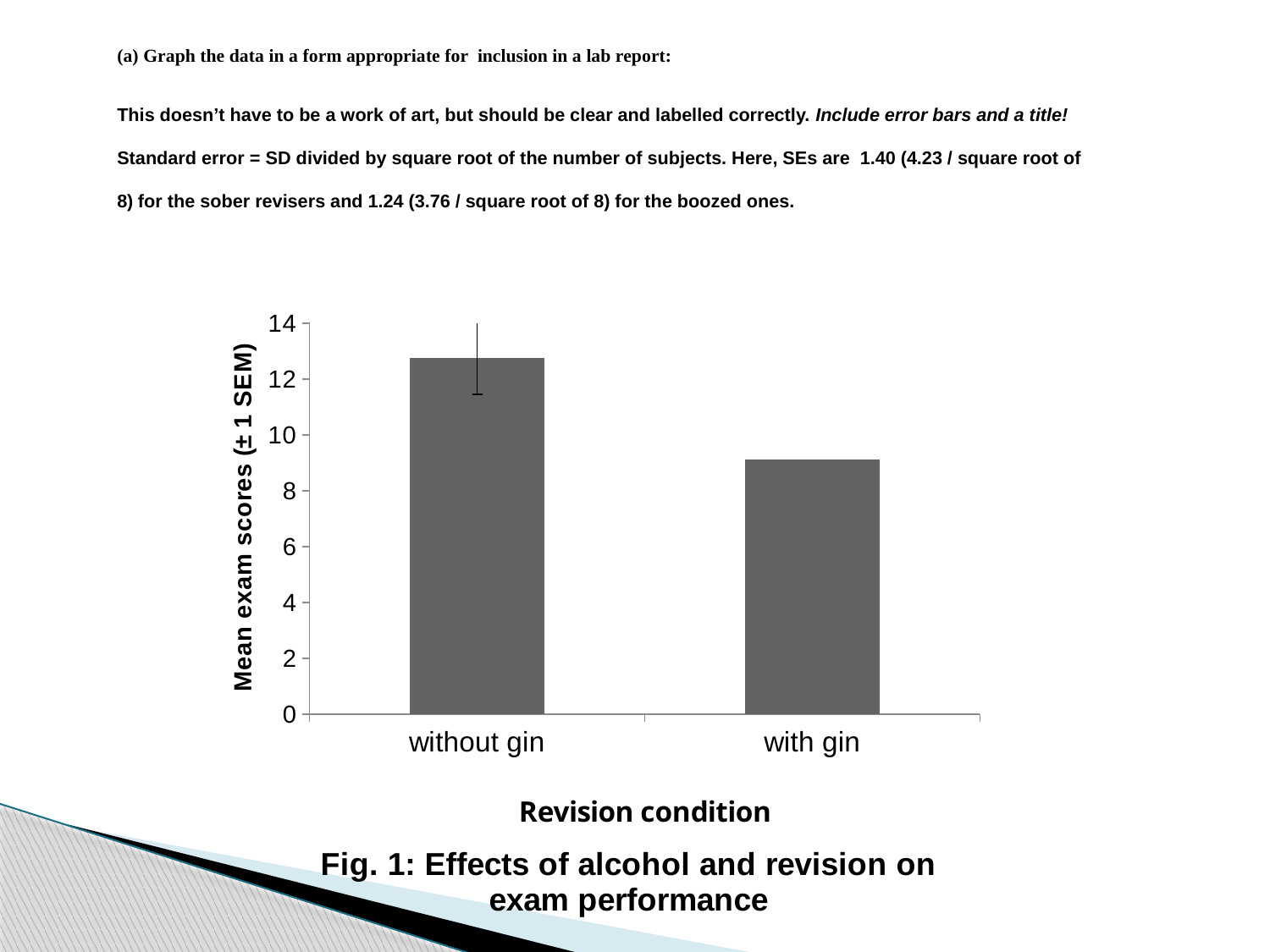
Is the mean exam score for without gin greater or less than 14? less What is the label on the vertical axis of the chart? Mean exam scores (± 1 SEM) How many revision conditions are plotted on the chart? 2 Do the mean exam scores rise or fall from without gin to with gin? fall Which revision condition has the highest mean exam score? without gin Is the mean exam score for with gin greater or less than 10? less Is the mean exam score for without gin greater or less than 12? greater Which revision condition has the lowest mean exam score? with gin Which has the larger mean exam score, without gin or with gin? without gin What kind of chart is shown on the slide? bar chart What is the title of the chart? Fig. 1: Effects of alcohol and revision on exam performance